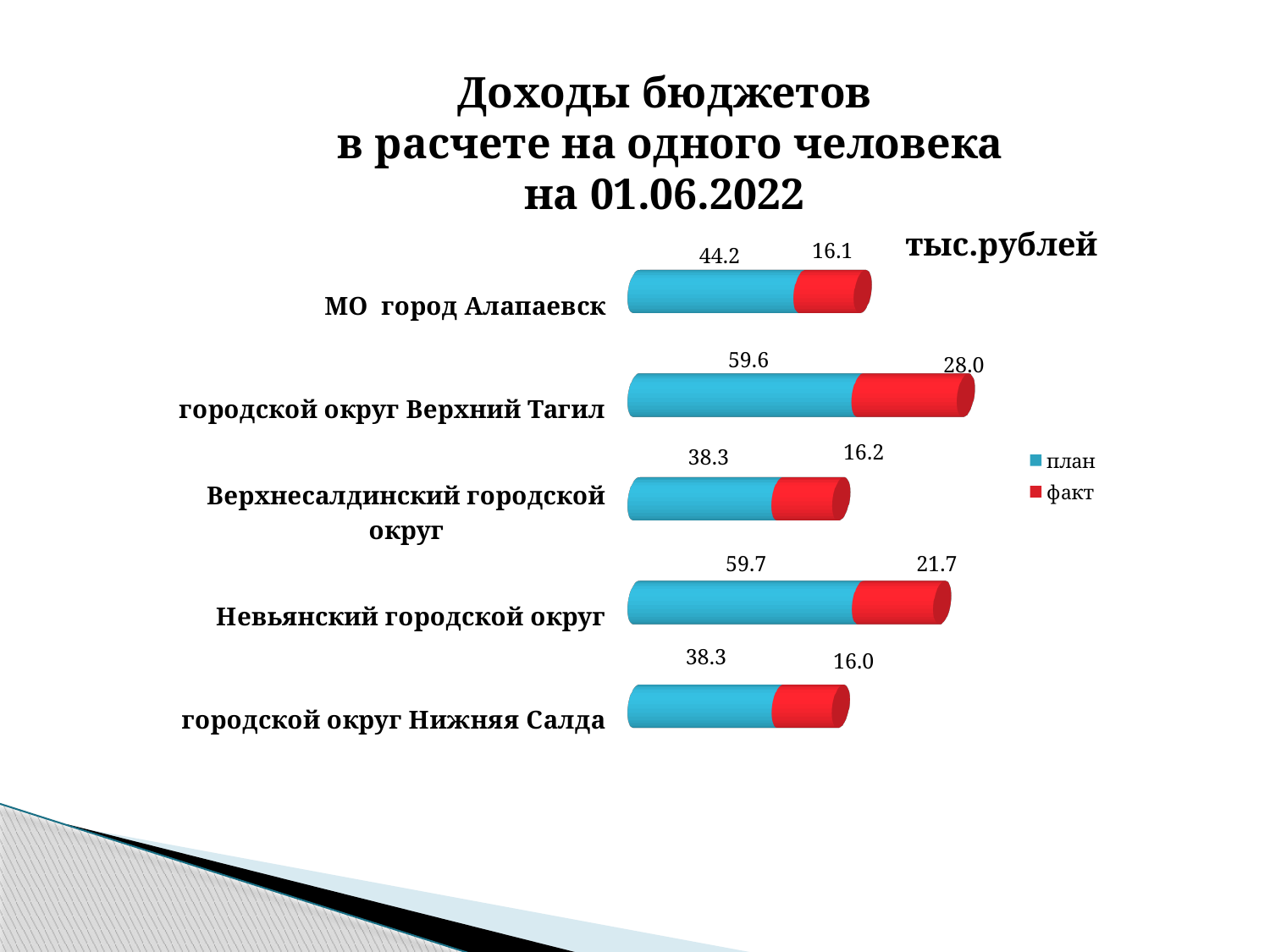
Which is larger: the факт value for городской округ Верхний Тагил or for Невьянский городской округ? городской округ Верхний Тагил How many series does the legend list? 2 Which category has the highest факт value? городской округ Верхний Тагил What is the difference between the план and факт values for городской округ Верхний Тагил? 31.6 What is the total of the stacked bar for МО город Алапаевск? 60.3 What is the факт value for городской округ Нижняя Салда? 16.0 How many categories are shown in the chart? 5 What kind of chart is shown on the slide? Stacked bar chart What is the план value for городской округ Верхний Тагил? 59.6 What is the факт value for Невьянский городской округ? 21.7 What is the план value for МО город Алапаевск? 44.2 What is the difference between the план and факт values for Невьянский городской округ? 38.0